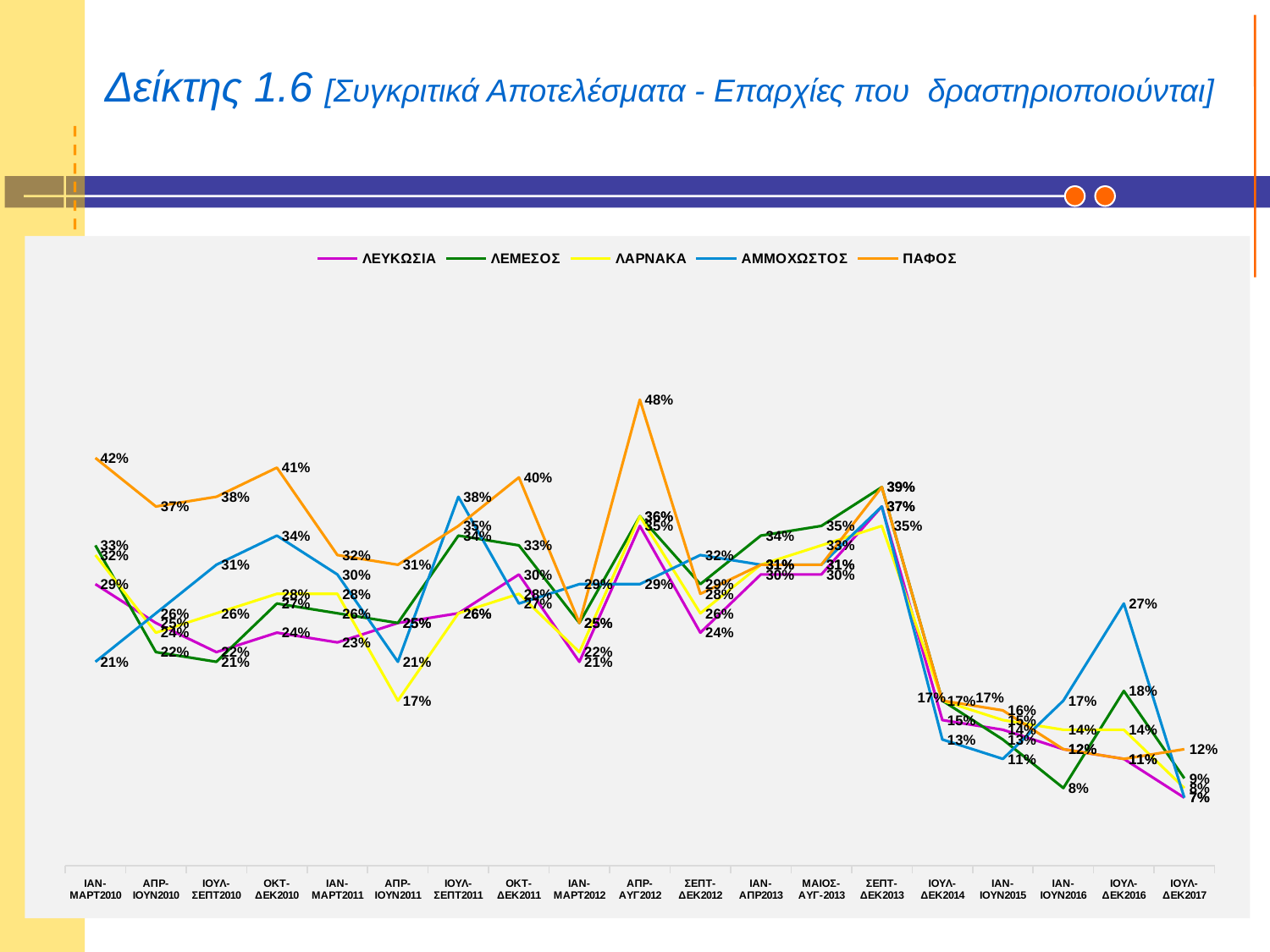
Which colour is used for the ΑΜΜΟΧΩΣΤΟΣ line? Blue In ΙΑΝ-ΜΑΡΤ2010, which is larger: the value for ΠΑΦΟΣ or the value for ΑΜΜΟΧΩΣΤΟΣ? ΠΑΦΟΣ What is the difference between the ΠΑΦΟΣ value in ΑΠΡ-ΑΥΓ2012 and its value in ΙΑΝ-ΜΑΡΤ2010? 6 percentage points How many series does the legend list? 5 What is the value for ΛΑΡΝΑΚΑ in ΑΠΡ-ΙΟΥΝ2011? 17% What is the value for ΠΑΦΟΣ in ΙΑΝ-ΜΑΡΤ2010? 42% What is the value for ΠΑΦΟΣ in ΑΠΡ-ΑΥΓ2012? 48% What kind of chart is shown on the slide? Line chart What is the value for ΑΜΜΟΧΩΣΤΟΣ in ΙΟΥΛ-ΔΕΚ2016? 27% How many time periods are shown along the x axis? 19 What is the value for ΛΕΜΕΣΟΣ in ΙΑΝ-ΙΟΥΝ2016? 8% In which period does ΠΑΦΟΣ reach its highest value? ΑΠΡ-ΑΥΓ2012